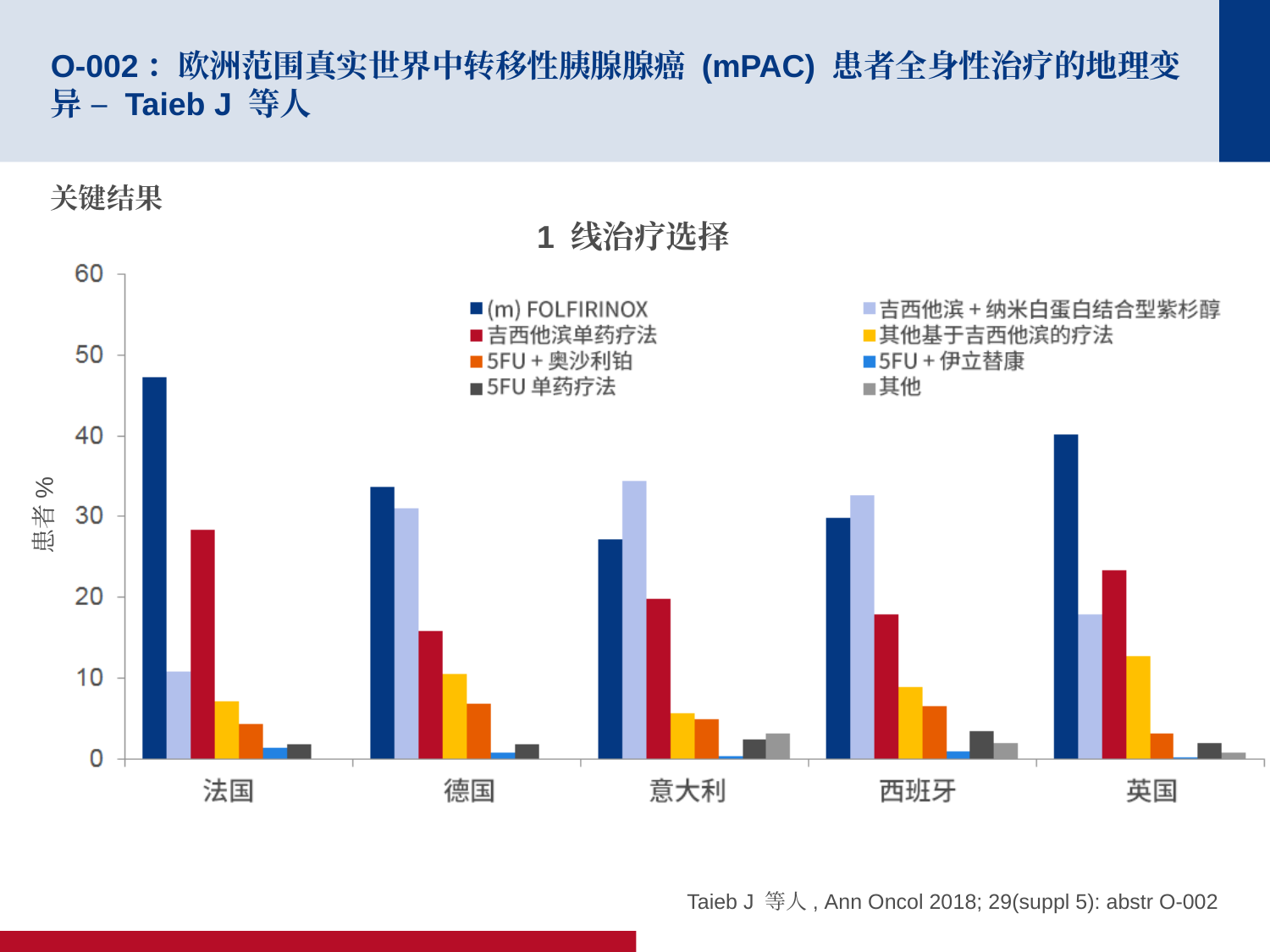
Which country has the highest value for (m) FOLFIRINOX? 法国 Which is larger: 吉西他滨单药疗法 in 法国 or 吉西他滨单药疗法 in 英国? 法国 How many series does the chart legend list? 8 In 意大利, which is larger: (m) FOLFIRINOX or 吉西他滨 + 纳米白蛋白结合型紫杉醇? 吉西他滨 + 纳米白蛋白结合型紫杉醇 Is the value for (m) FOLFIRINOX in 法国 greater or less than 40? greater Is the value for (m) FOLFIRINOX in 英国 greater or less than 30? greater In 英国, which is larger: 吉西他滨单药疗法 or 吉西他滨 + 纳米白蛋白结合型紫杉醇? 吉西他滨单药疗法 What is the label of the y axis of the chart? 患者 % What kind of chart is shown on the slide? Bar chart Is the value for 吉西他滨 + 纳米白蛋白结合型紫杉醇 in 意大利 greater or less than 30? greater Which country has the lowest value for (m) FOLFIRINOX? 意大利 How many countries are shown on the x axis of the chart? 5